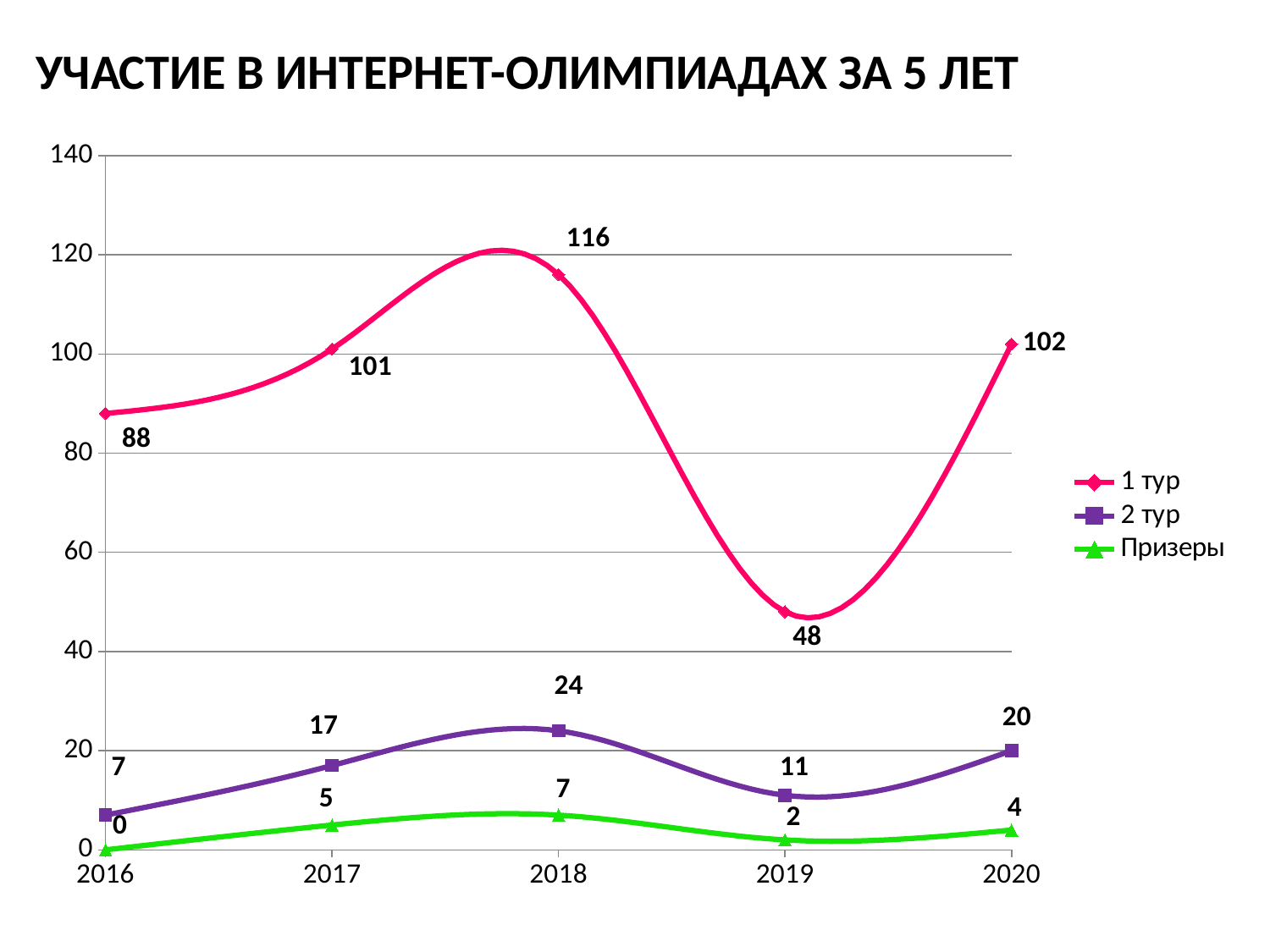
In which year is the value for 1 тур the lowest? 2019 What is the difference between the 1 тур values for 2018 and 2019? 68 What is the value for Призеры in 2020? 4 What is the value for 2 тур in 2017? 17 Does the 2 тур series rise or fall from 2016 to 2018? rise What is the value for 1 тур in 2018? 116 What is the title of the chart? УЧАСТИЕ В ИНТЕРНЕТ-ОЛИМПИАДАХ ЗА 5 ЛЕТ How many years are shown on the x axis? 5 What kind of chart is shown on the slide? line chart How many series does the legend list? 3 Which is larger: the 2 тур value in 2018 or in 2020? 2018 In which year is the value for 1 тур the highest? 2018